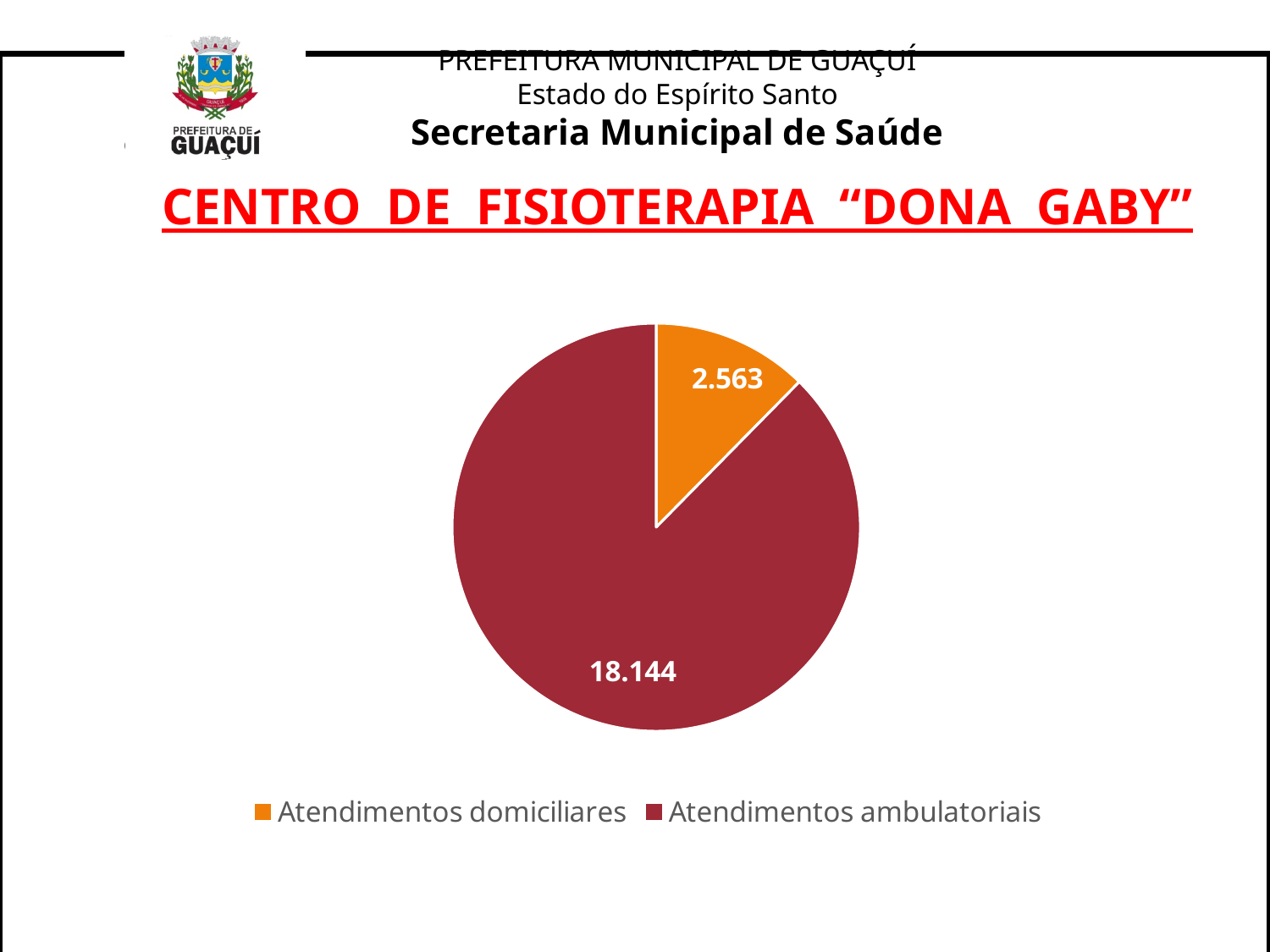
What is the difference between Atendimentos ambulatoriais and Atendimentos domiciliares? 15.581 What is the total of the two slices in the pie chart? 20.707 Which category has the smallest slice of the pie? Atendimentos domiciliares Which is larger, Atendimentos domiciliares or Atendimentos ambulatoriais? Atendimentos ambulatoriais What share of the pie does Atendimentos domiciliares represent? 12.4% How many slices does the pie chart have? 2 What is the value for Atendimentos domiciliares? 2.563 What colour is the slice for Atendimentos domiciliares? orange What is the value for Atendimentos ambulatoriais? 18.144 How many entries does the legend list? 2 Which category has the largest slice of the pie? Atendimentos ambulatoriais What kind of chart is shown on the slide? pie chart